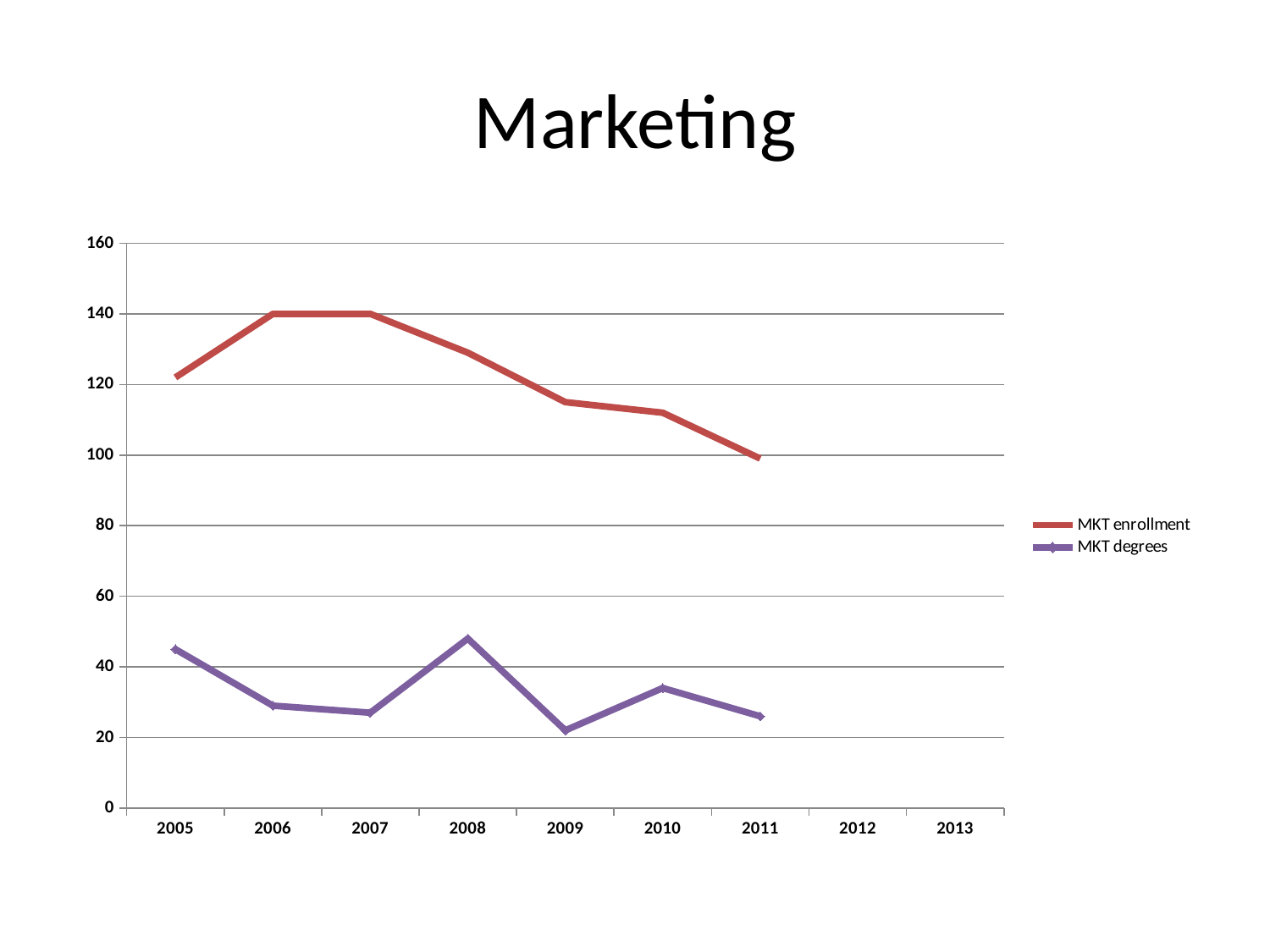
How many series does the legend list? 2 What kind of chart is shown on the slide? line chart Which is larger, MKT enrollment in 2005 or MKT enrollment in 2011? 2005 Does MKT enrollment rise or fall from 2007 to 2011? fall In which year is MKT enrollment lowest? 2011 How many years have data points plotted for MKT enrollment? 7 What is the value of MKT enrollment in 2007? 140 What is the title of the slide's chart? Marketing Is the value for MKT enrollment in 2009 greater or less than 120? less Is the value for MKT degrees in 2008 greater or less than 40? greater What is the value of MKT enrollment in 2006? 140 In which year is MKT degrees lowest? 2009